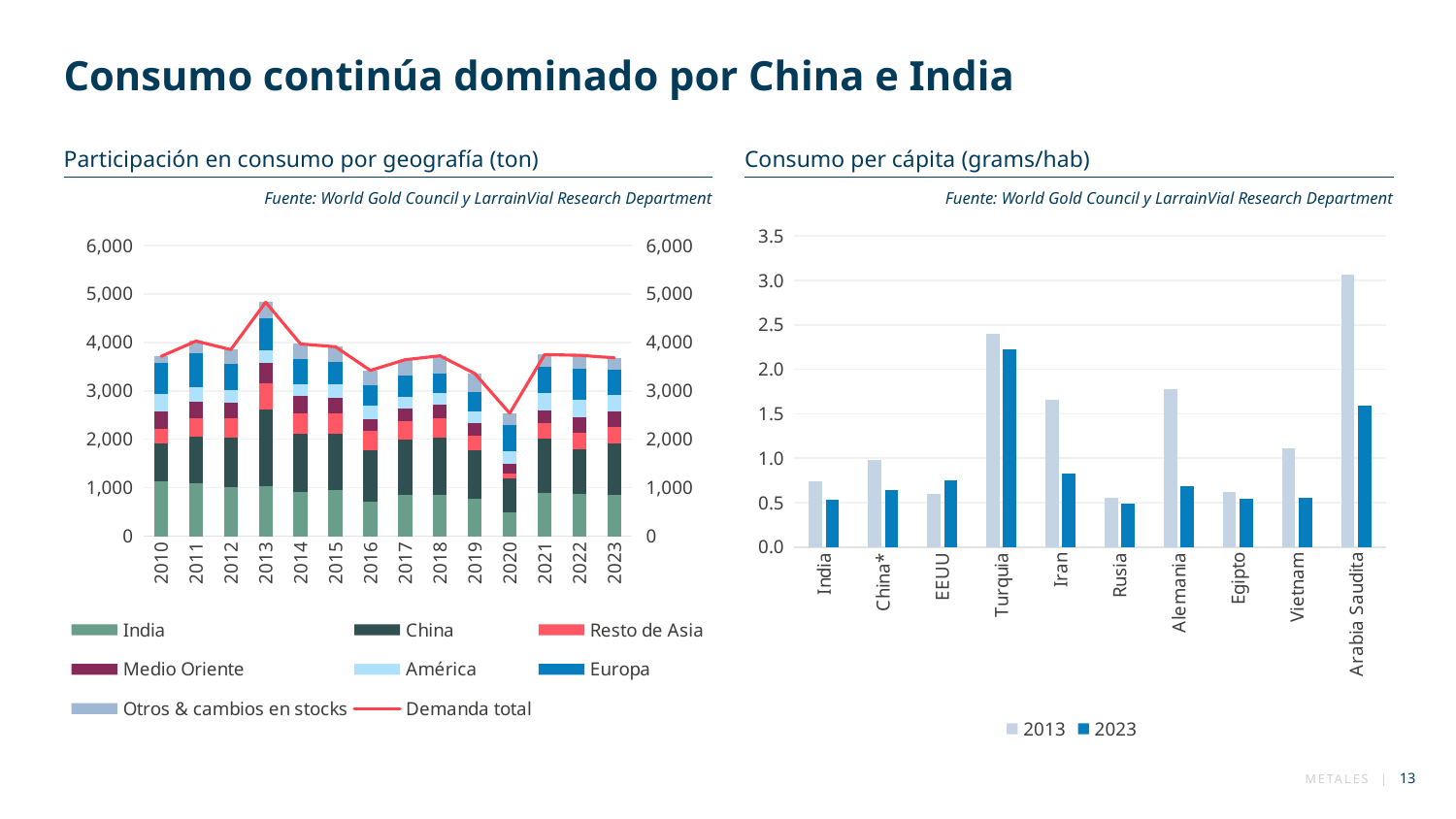
In the left chart, 'Participación en consumo por geografía (ton)', in which year does the 'Demanda total' line reach its lowest value? 2020 What kind of chart is the left chart, 'Participación en consumo por geografía (ton)'? Stacked bar chart with a line In the right chart, 'Consumo per cápita (grams/hab)', which is larger for Alemania: the 2013 value or the 2023 value? 2013 In the right chart, 'Consumo per cápita (grams/hab)', which country has the highest 2013 value? Arabia Saudita In the right chart, 'Consumo per cápita (grams/hab)', how many countries are shown on the x axis? 10 In the left chart, 'Participación en consumo por geografía (ton)', how many years are shown on the x axis? 14 How many series does the legend of the right chart, 'Consumo per cápita (grams/hab)', list? 2 In the right chart, 'Consumo per cápita (grams/hab)', is the 2013 value for Turquia greater or less than 2.0? greater What kind of chart is the right chart, 'Consumo per cápita (grams/hab)'? Bar chart In the left chart, 'Participación en consumo por geografía (ton)', is the 'Demanda total' value for 2020 greater or less than 3,000? less How many entries does the legend of the left chart, 'Participación en consumo por geografía (ton)', list? 8 In the left chart, 'Participación en consumo por geografía (ton)', in which year does the 'Demanda total' line reach its highest value? 2013